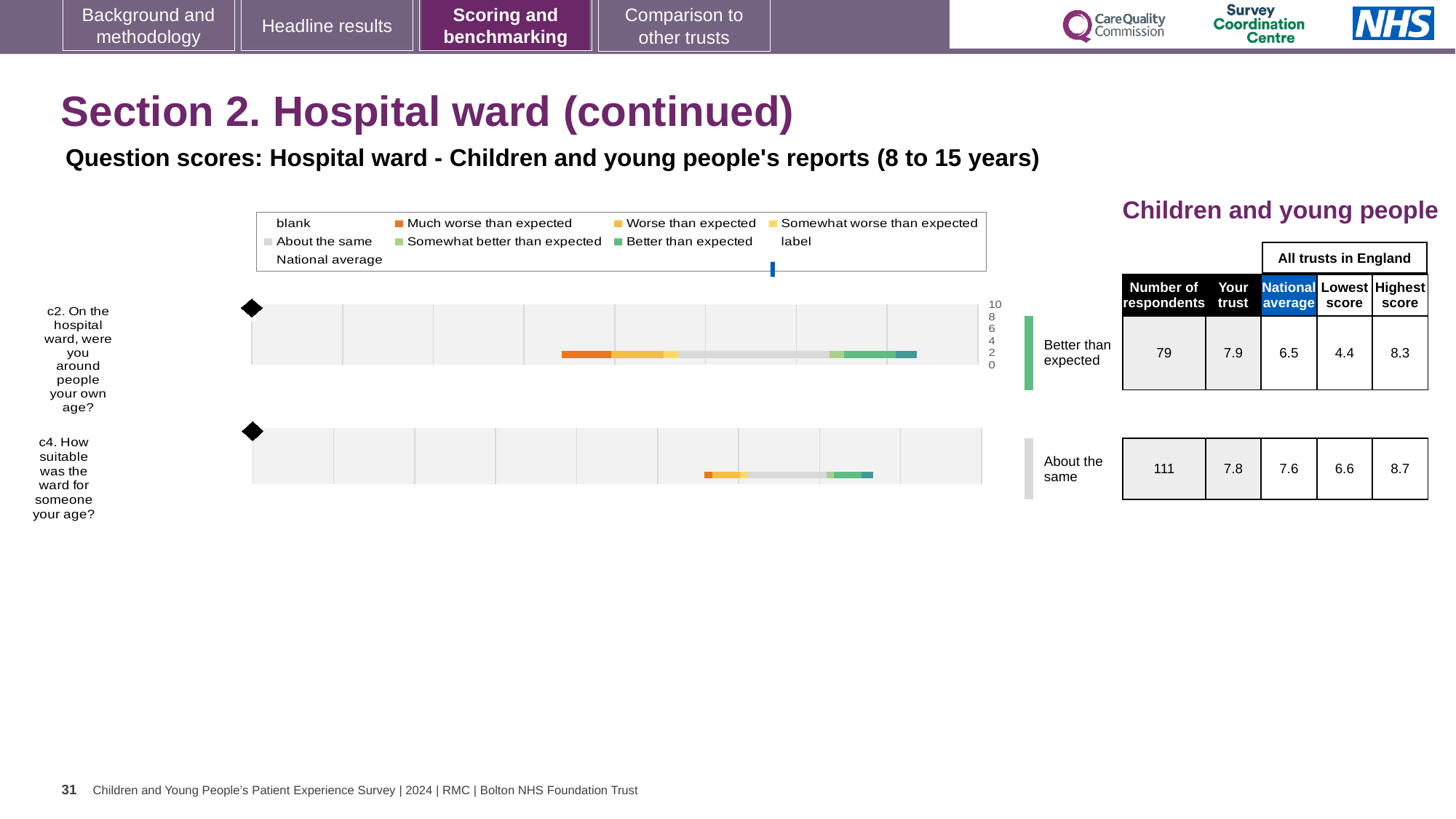
What kind of chart is used to show the question scores on this slide? bar chart What is the difference between the trust's score and the national average for question c2? 1.4 How many respondents answered question c4? 111 What is the national average score for question c4 (How suitable was the ward for someone your age?)? 7.6 Which benchmark category is question c4 placed in? About the same Which question has the higher lowest score across all trusts in England, c2 or c4? c4 What is the highest score among all trusts in England for question c2? 8.3 What is the 'Your trust' score for question c2 (On the hospital ward, were you around people your own age?)? 7.9 How many questions (chart rows) are plotted on the slide? 2 Which benchmark category is question c2 placed in? Better than expected How many entries does the chart legend list? 9 What is the maximum value shown on the chart's score axis? 10